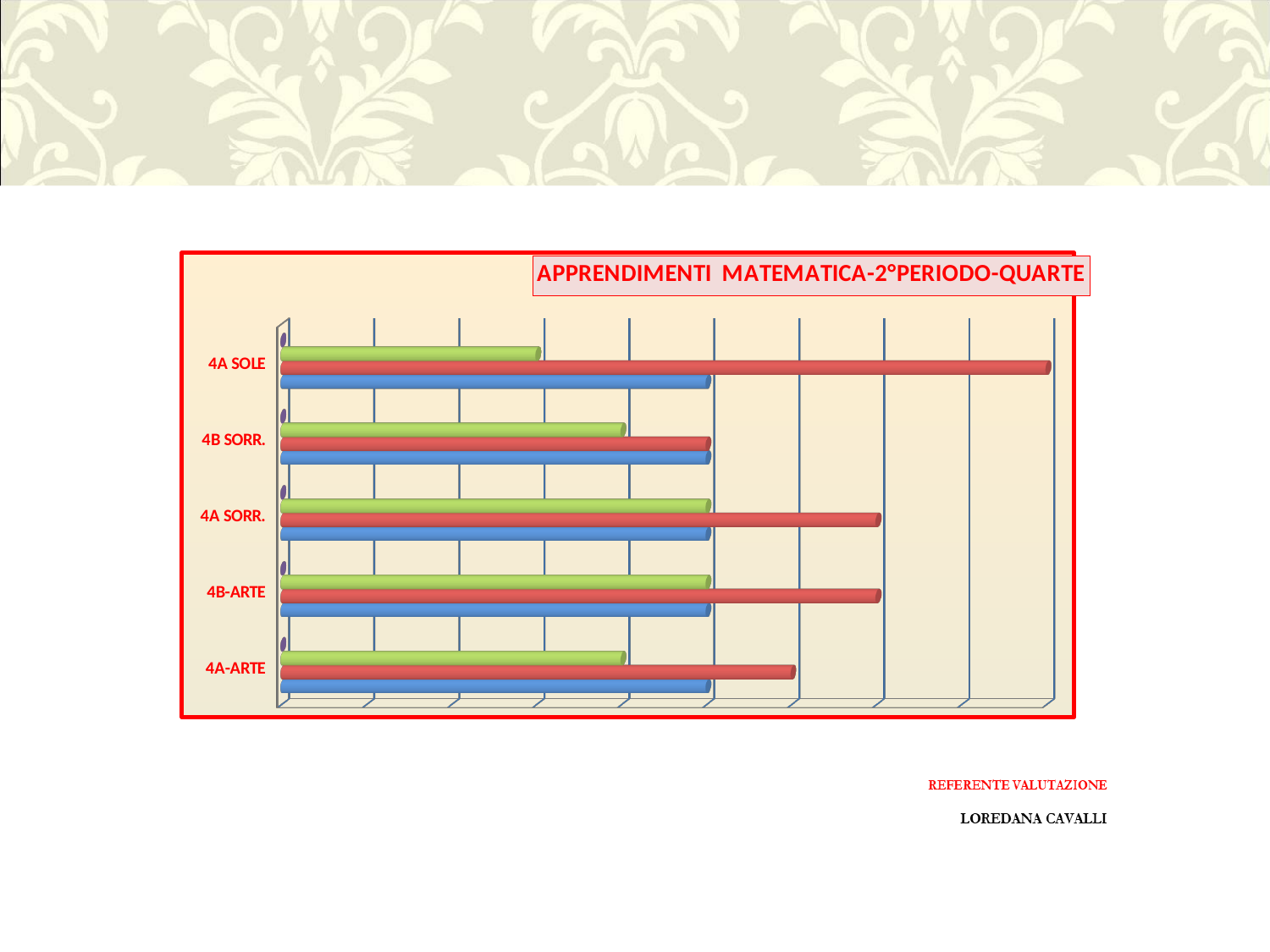
What is the title of the chart? APPRENDIMENTI MATEMATICA-2°PERIODO-QUARTE Which category is listed at the top of the vertical axis? 4A SOLE What kind of chart is shown on the slide? bar chart Is the green bar longer for 4B-ARTE or for 4A-ARTE? 4B-ARTE Which category has the shortest green bar? 4A SOLE How many categories (classes) are shown on the vertical axis of the chart? 5 Is the red bar longer for 4A SOLE or for 4A-ARTE? 4A SOLE For 4A SOLE, is the red bar longer or shorter than the green bar? longer Which category has the shortest red bar? 4B SORR. Which category has the longest red bar? 4A SOLE How many bars are plotted for each category in the chart? 3